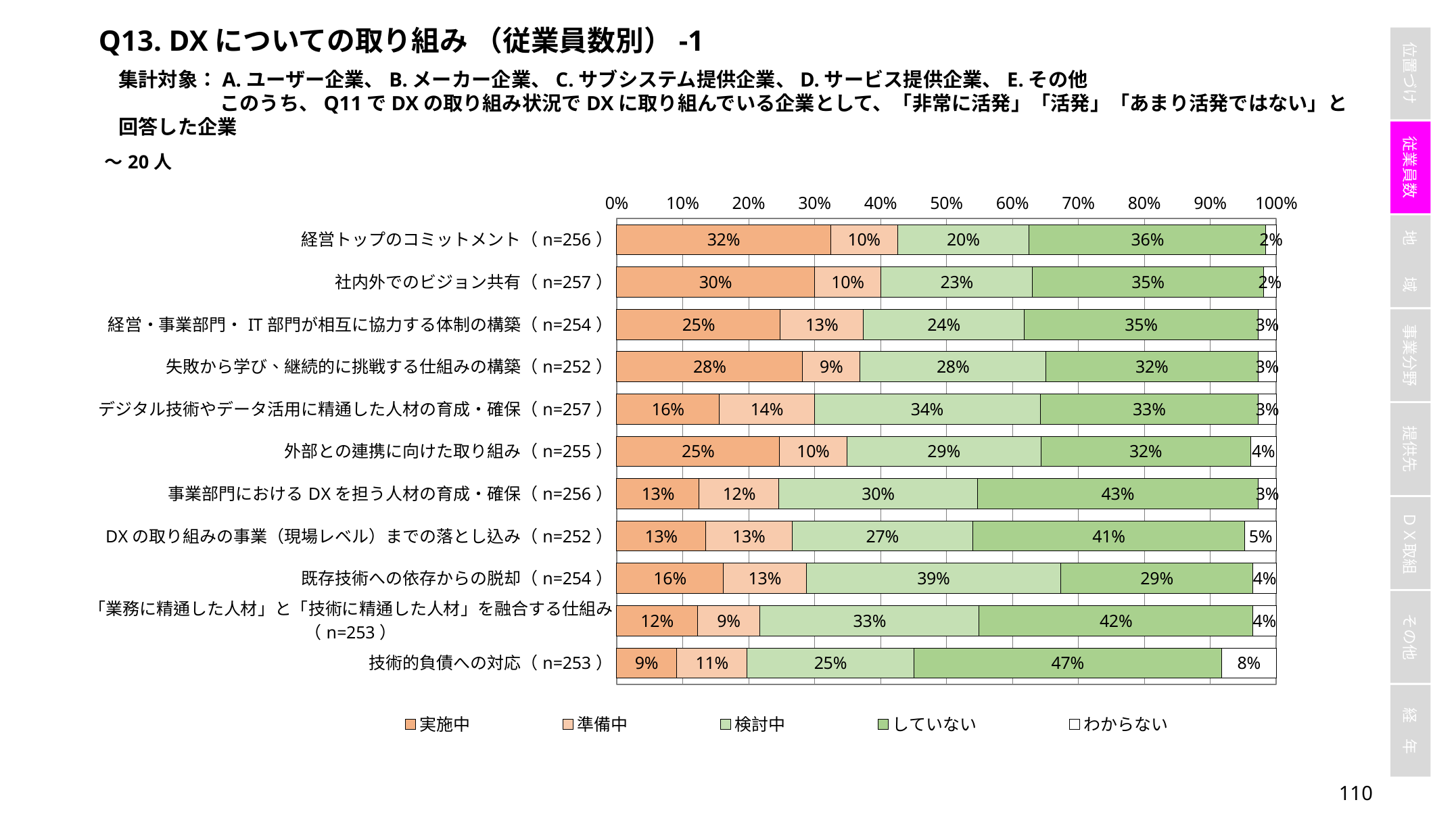
Which category has the lowest 実施中 value? 技術的負債への対応 What is the 検討中 value for 既存技術への依存からの脱却? 39% What is the していない value for 技術的負債への対応? 47% Which category has the highest 実施中 value? 経営トップのコミットメント Which category has the highest わからない value? 技術的負債への対応 What is the 実施中 value for 経営トップのコミットメント? 32% Which is larger: the 検討中 value for デジタル技術やデータ活用に精通した人材の育成・確保 or the 検討中 value for 経営トップのコミットメント? デジタル技術やデータ活用に精通した人材の育成・確保 What type of chart is shown on the slide? Stacked bar chart What is the difference between the 実施中 values for 経営トップのコミットメント and 技術的負債への対応? 23% How many series does the legend list? 5 What is the label of the first legend entry? 実施中 How many categories (items) are plotted in the chart? 11